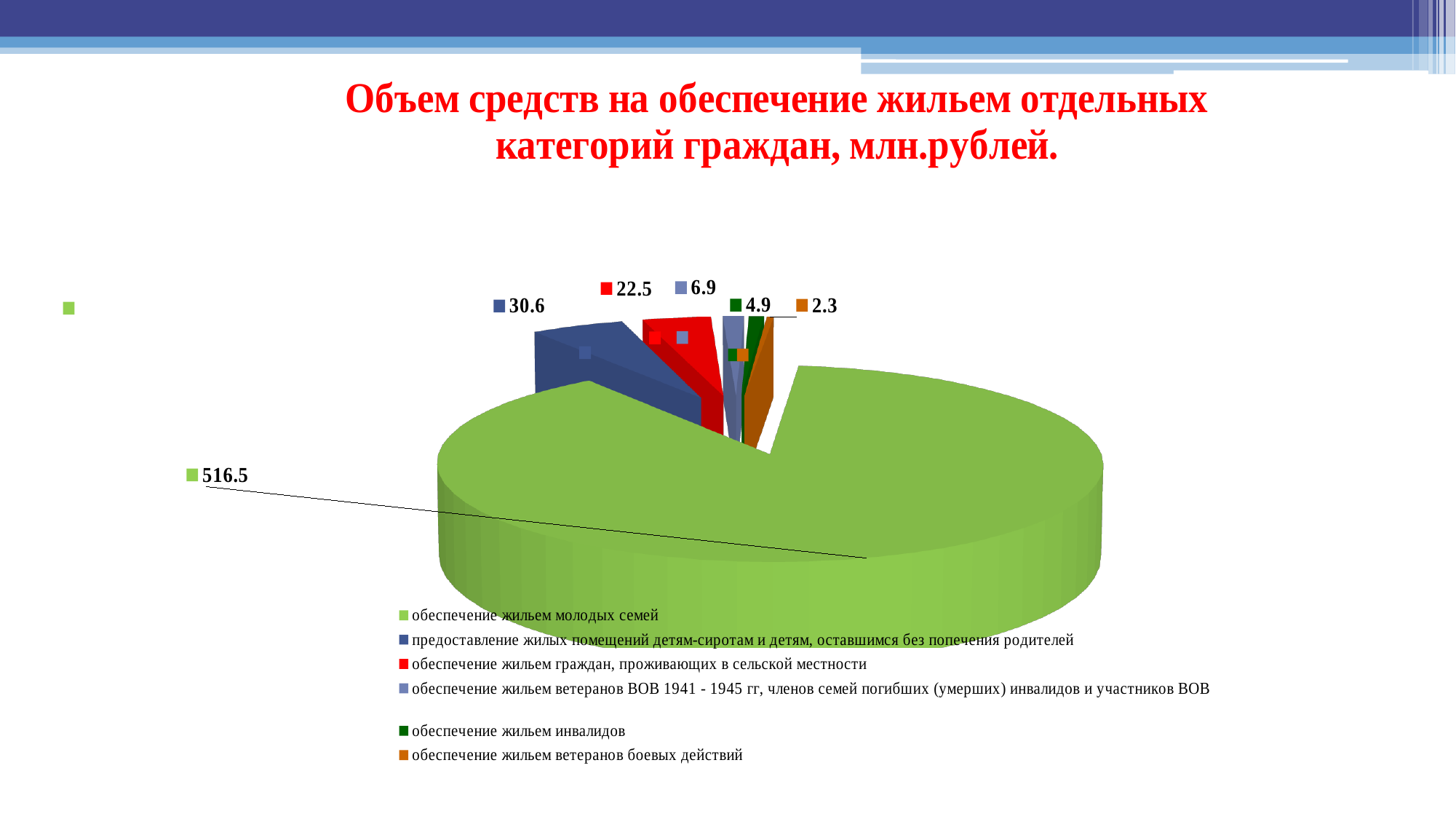
Which is larger: the value for "обеспечение жильем ветеранов ВОВ 1941 - 1945 гг, членов семей погибших (умерших) инвалидов и участников ВОВ" or the value for "обеспечение жильем инвалидов"? обеспечение жильем ветеранов ВОВ 1941 - 1945 гг, членов семей погибших (умерших) инвалидов и участников ВОВ What is the value for "обеспечение жильем молодых семей"? 516.5 What type of chart is shown on the slide? pie chart What is the value for "обеспечение жильем инвалидов"? 4.9 What is the value for "обеспечение жильем ветеранов боевых действий"? 2.3 Which category has the largest value? обеспечение жильем молодых семей What is the value for "предоставление жилых помещений детям-сиротам и детям, оставшимся без попечения родителей"? 30.6 What is the difference between the values for "предоставление жилых помещений детям-сиротам и детям, оставшимся без попечения родителей" and "обеспечение жильем граждан, проживающих в сельской местности"? 8.1 How many categories does the pie chart have? 6 What is the value for "обеспечение жильем граждан, проживающих в сельской местности"? 22.5 Which category has the smallest value? обеспечение жильем ветеранов боевых действий What is the title of the chart? Объем средств на обеспечение жильем отдельных категорий граждан, млн.рублей.